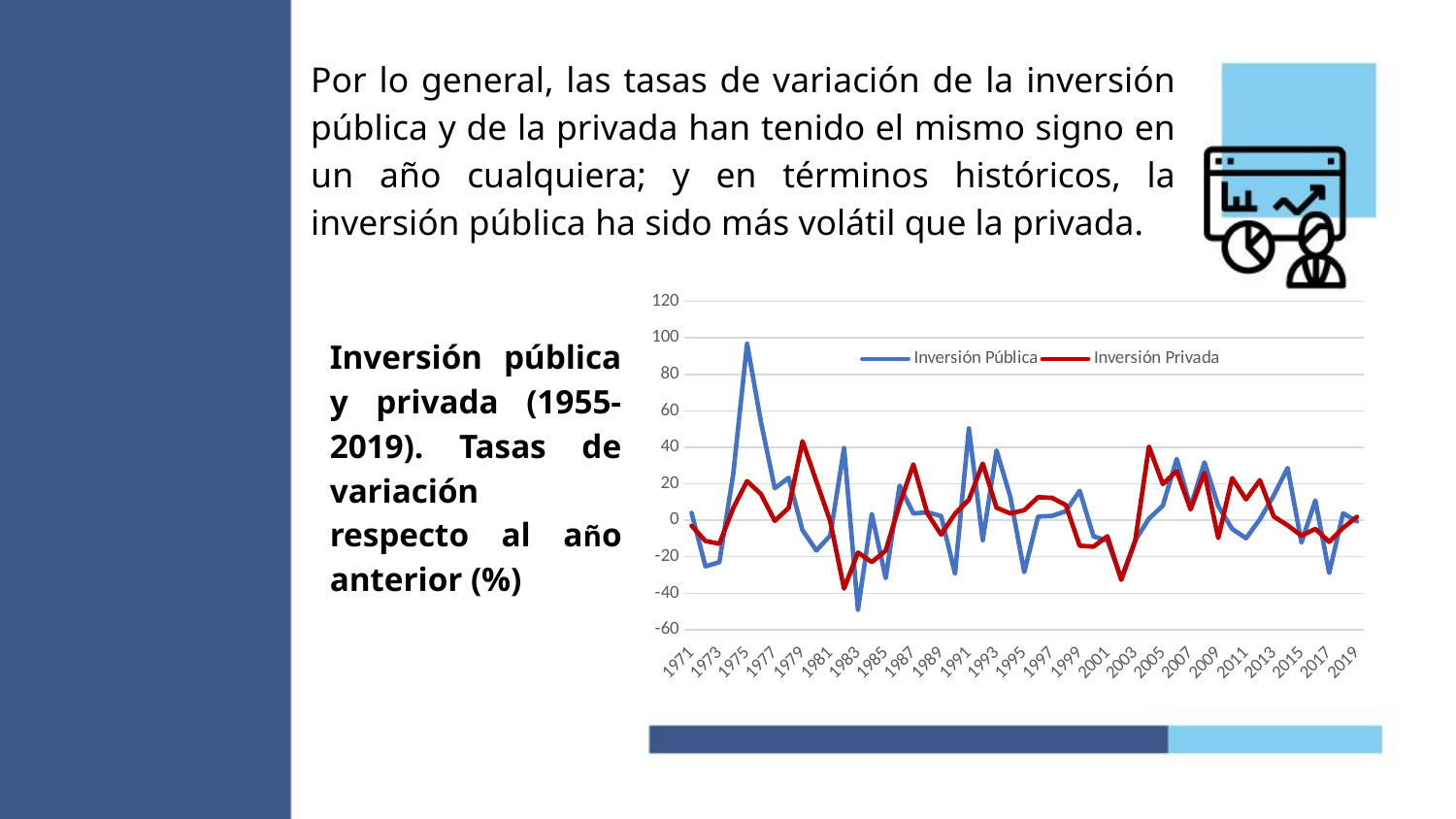
In 1975, which series has the higher value, Inversión Pública or Inversión Privada? Inversión Pública Is the value for Inversión Pública in 1983 greater or less than -40? less What is the title of the chart on the slide? Inversión pública y privada (1955-2019). Tasas de variación respecto al año anterior (%) How many series does the chart legend list? 2 In which year does the Inversión Pública series reach its highest peak? 1975 Which series is drawn in red in the chart? Inversión Privada Is the value for Inversión Pública in 1991 greater or less than 40? greater Which series reaches the highest value anywhere on the chart? Inversión Pública What kind of chart is shown on the slide? line chart In 1983, which series has the lower value, Inversión Pública or Inversión Privada? Inversión Pública Is the value for Inversión Pública in 1975 greater or less than 80? greater